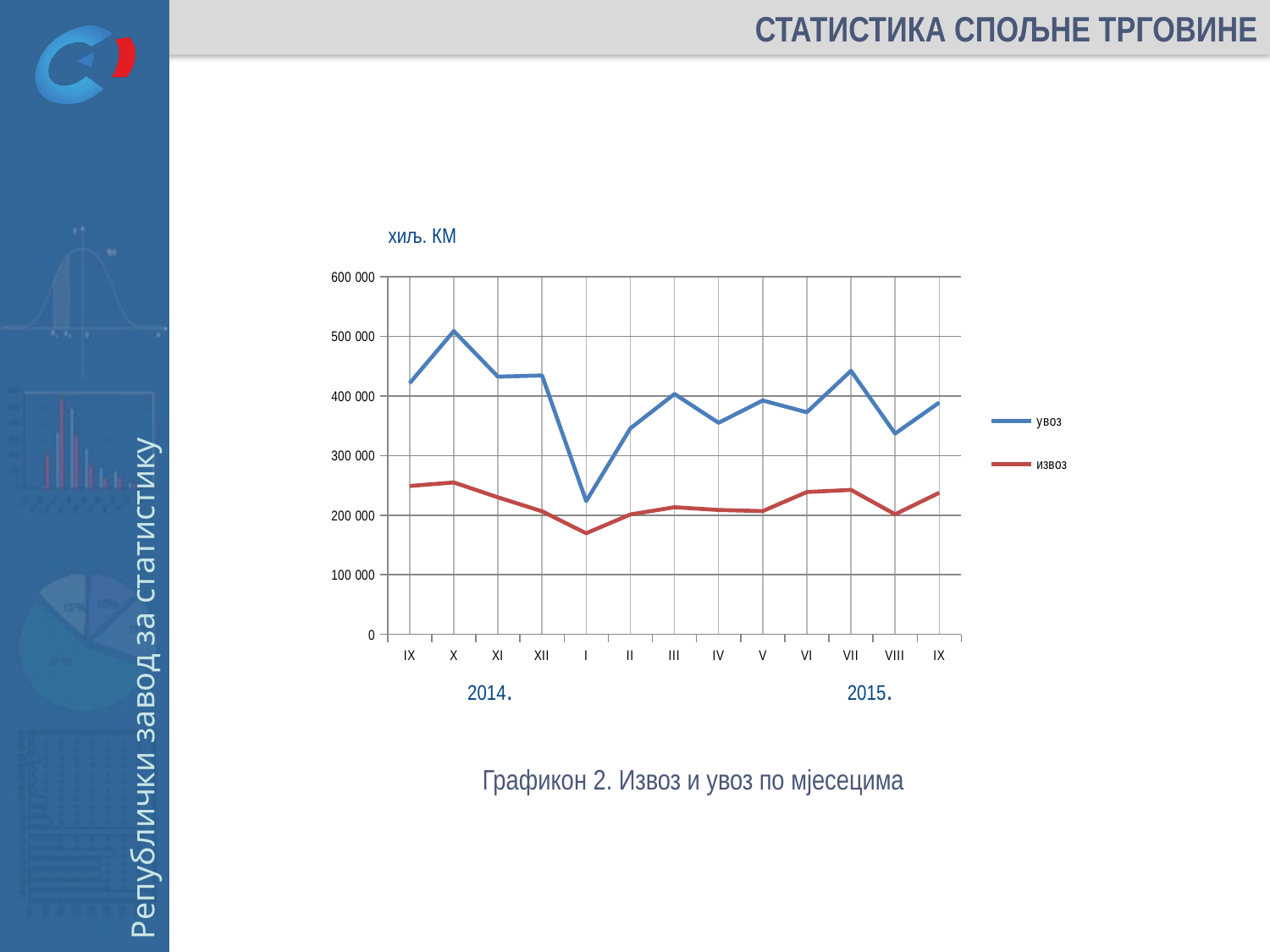
Is the value for увоз in X 2014 greater or less than 500 000? greater What unit is shown above the y axis? хиљ. КМ In which month is the value for увоз highest? X 2014 How many months are plotted along the x axis? 13 What kind of chart is shown on the slide? line chart Is the value for увоз in I 2015 greater or less than 300 000? less Is the value for извоз in I 2015 greater or less than 200 000? less In which month is the value for извоз lowest? I 2015 What is the caption of the chart? Графикон 2. Извоз и увоз по мјесецима In which month is the value for увоз lowest? I 2015 How many series does the legend list? 2 Which is larger in VII 2015, увоз or извоз? увоз